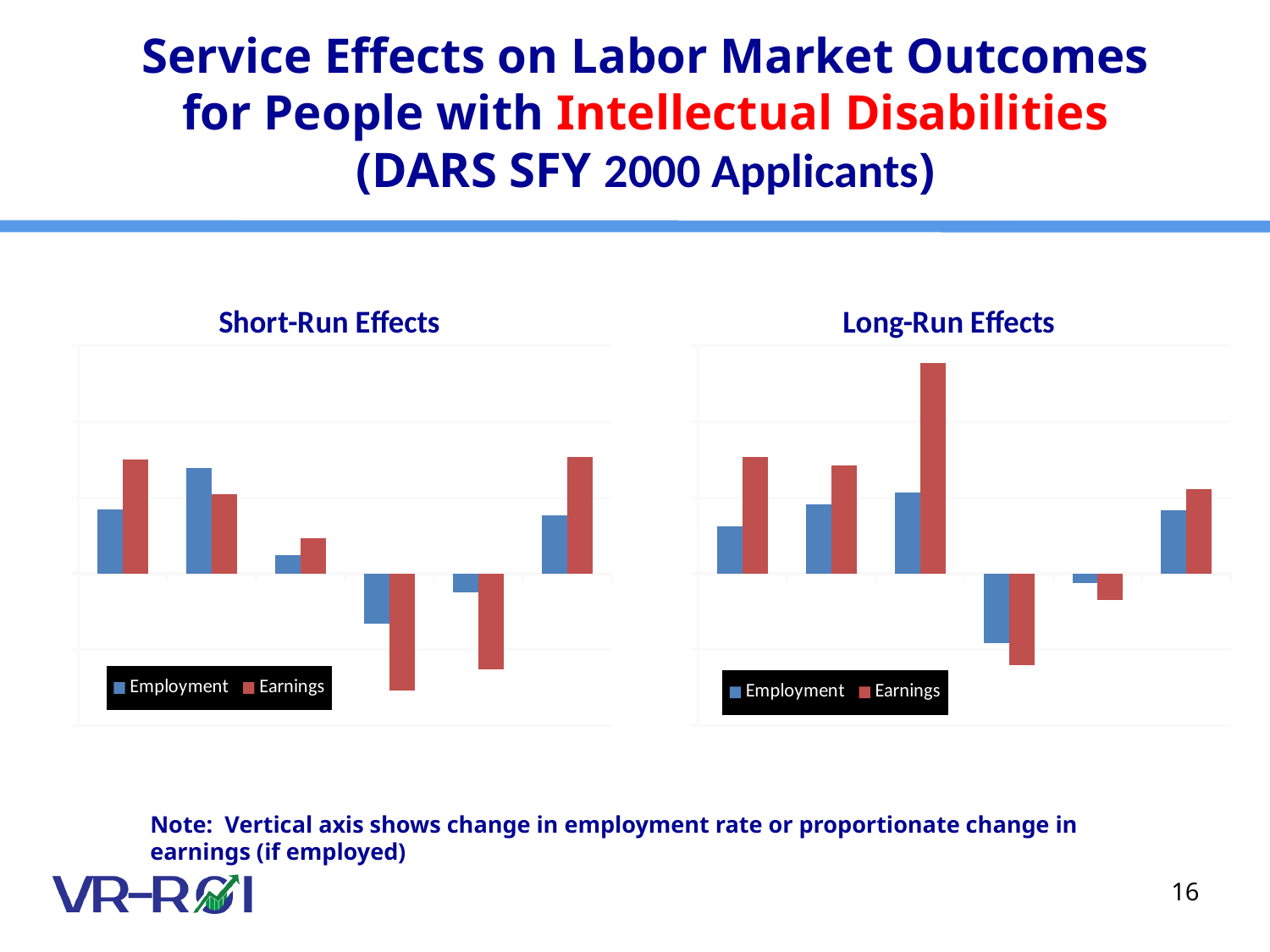
How many groups of bars are plotted in the Long-Run Effects chart? 6 In the Short-Run Effects chart, which series has the lowest (most negative) bar? Earnings What kind of chart is the Long-Run Effects chart? Bar chart In the Short-Run Effects chart, which colour represents the Employment series? Blue How many groups of bars are plotted in the Short-Run Effects chart? 6 How many series does the legend of the Long-Run Effects chart list? 2 What kind of chart is the Short-Run Effects chart? Bar chart What are the two series named in the legend of the Long-Run Effects chart? Employment and Earnings How many series does the legend of the Short-Run Effects chart list? 2 In the Long-Run Effects chart, which series has the tallest bar? Earnings